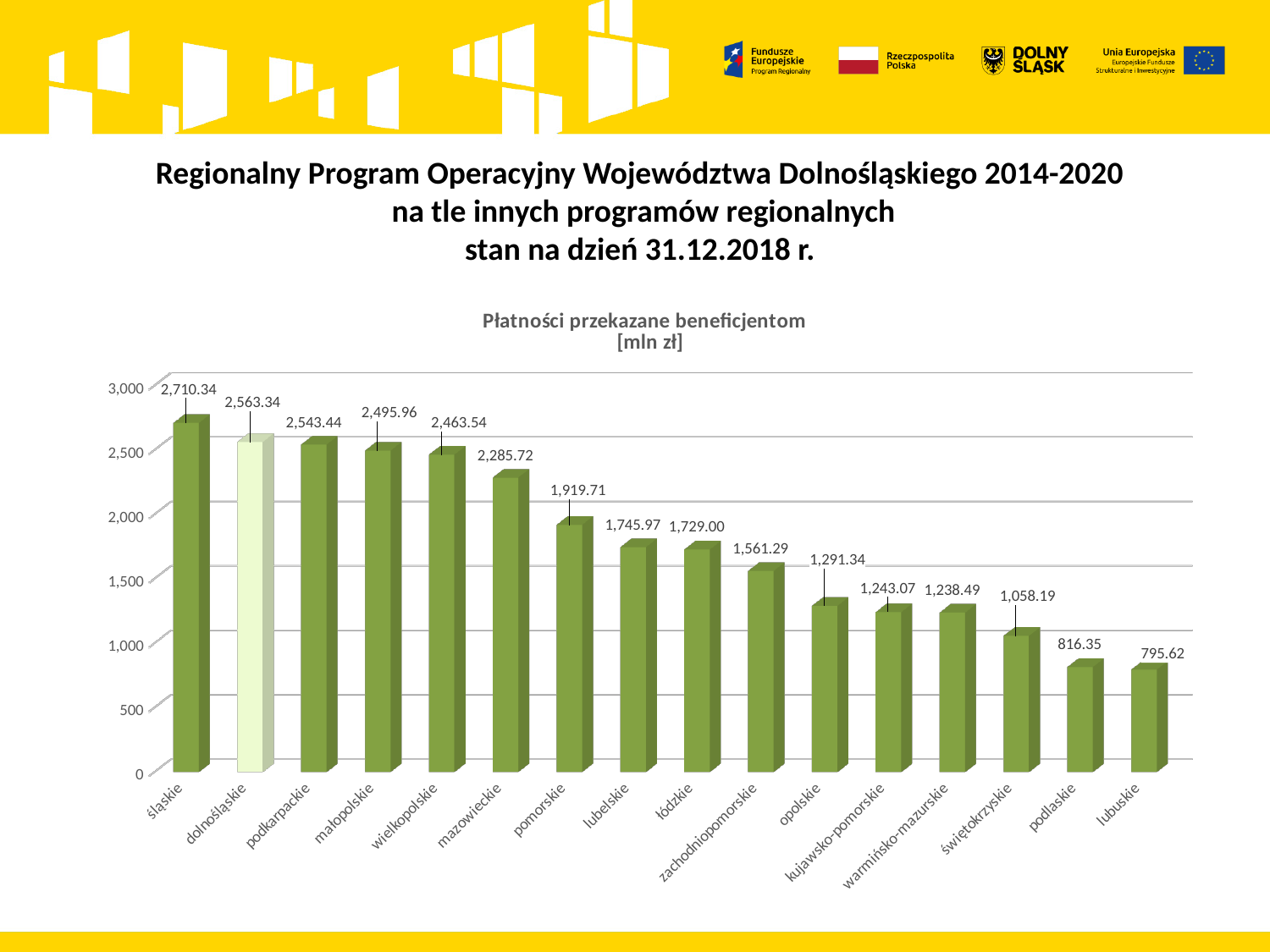
Which region has the highest value in the chart? śląskie What is the value for lubuskie in the chart? 795.62 Do the values rise or fall from left to right along the x axis? fall What kind of chart is shown on the slide? bar chart What is the title of the chart? Płatności przekazane beneficjentom [mln zł] Which region has the lowest value in the chart? lubuskie What is the value for dolnośląskie in the chart? 2,563.34 Which has the larger value, lubelskie or łódzkie? lubelskie What is the value for pomorskie in the chart? 1,919.71 What is the difference between the values for śląskie and dolnośląskie? 147.00 What is the difference between the values for podlaskie and lubuskie? 20.73 How many regions are shown in the chart? 16